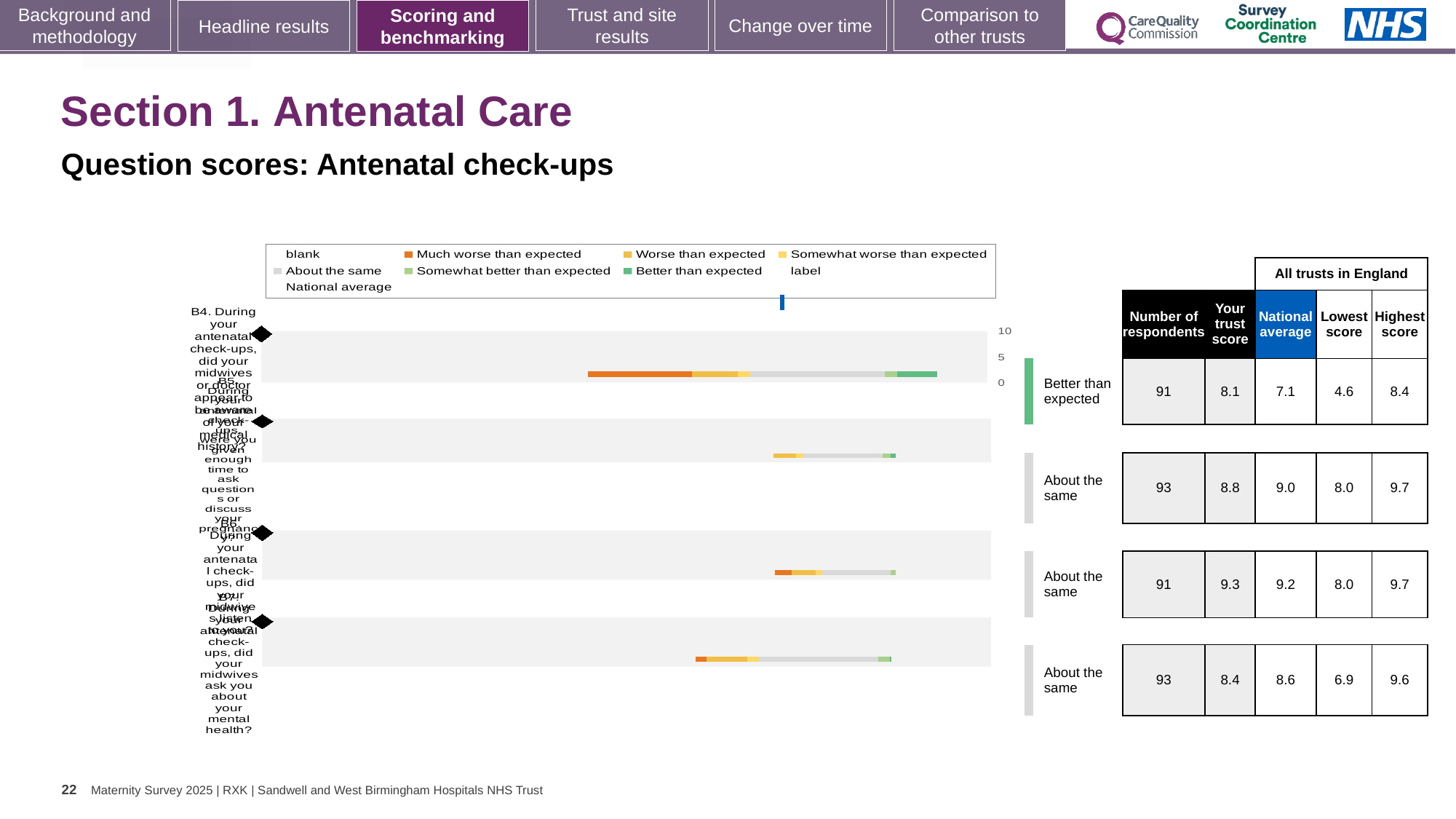
What kind of chart is shown on the slide? bar chart Which row in the table has the highest 'Your trust score'? the third row (B6), 9.3 Which row is rated 'Better than expected' rather than 'About the same'? the first row (B4) In the table beside the chart, what is the 'Your trust score' for the first row (question B4, about midwives or doctor being aware of your medical history)? 8.1 For the first row (B4), what is the difference between the trust score and the National average? 1.0 What is the Highest score across all trusts in England for the second row (B5)? 9.7 Which row in the table has the lowest 'Your trust score'? the first row (B4), 8.1 How many questions (bars) are plotted in the chart? 4 In the table beside the chart, what is the National average for the last row (question B7, about midwives asking about your mental health)? 8.6 For the second row (B5), which is larger: the trust score or the National average? National average (9.0) What is the Lowest score across all trusts in England for the first row (B4)? 4.6 How many respondents are listed for the last row (B7)? 93